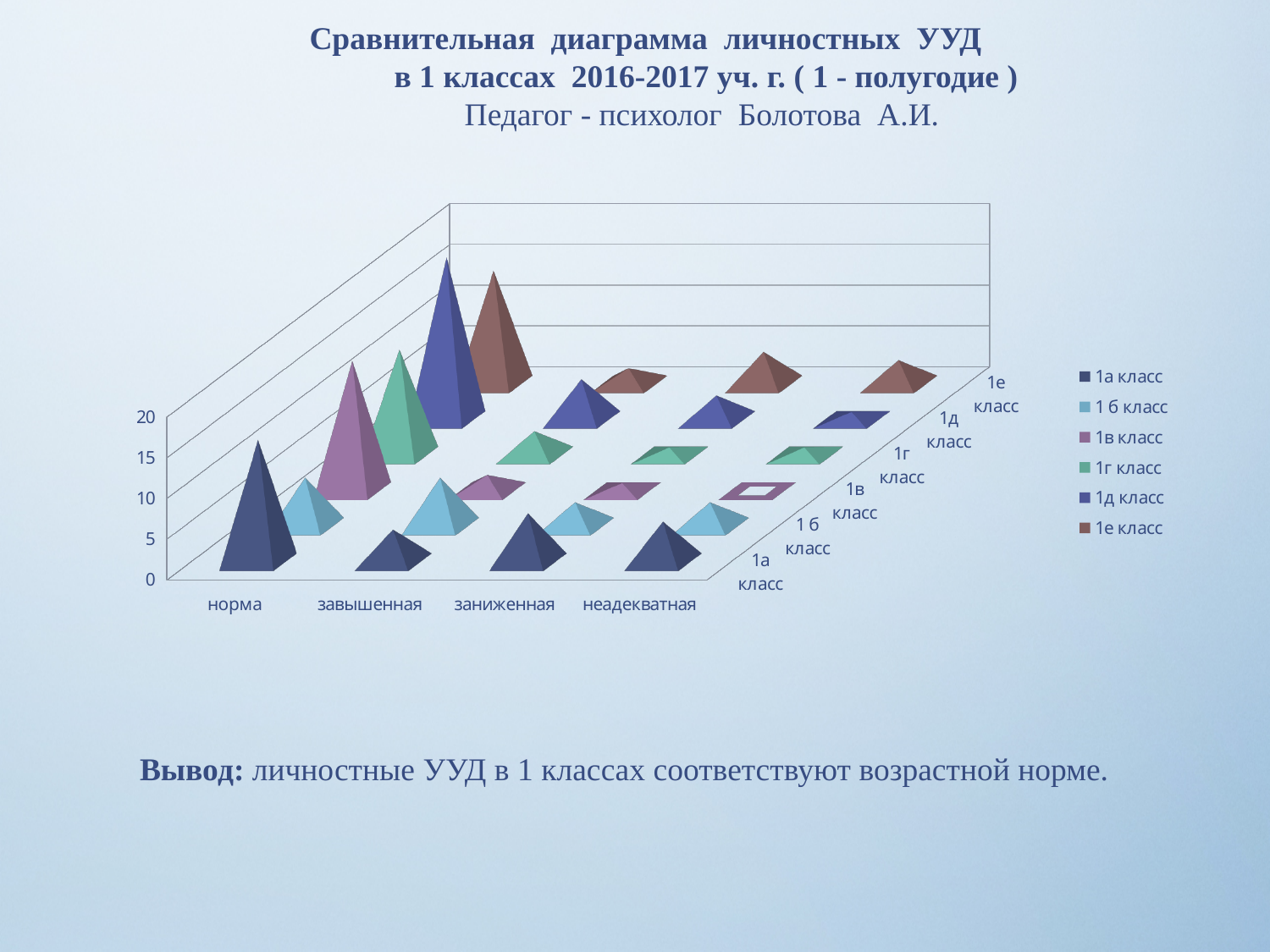
What kind of chart is shown on the slide? bar chart Is the value for 1в класс in the category неадекватная greater or less than 5? less For the series 1в класс, which category has the lowest value? неадекватная Is the value for 1а класс in the category неадекватная greater or less than 10? less What is the highest value shown on the vertical axis of the chart? 20 For the series 1а класс, which is larger: the value for норма or the value for завышенная? норма How many series does the chart legend list? 6 For the series 1д класс, which category has the highest value? норма Which series is listed first in the chart legend? 1а класс Which category on the x axis is listed first? норма For the series 1а класс, which category has the highest value? норма How many categories are shown on the x axis of the chart? 4